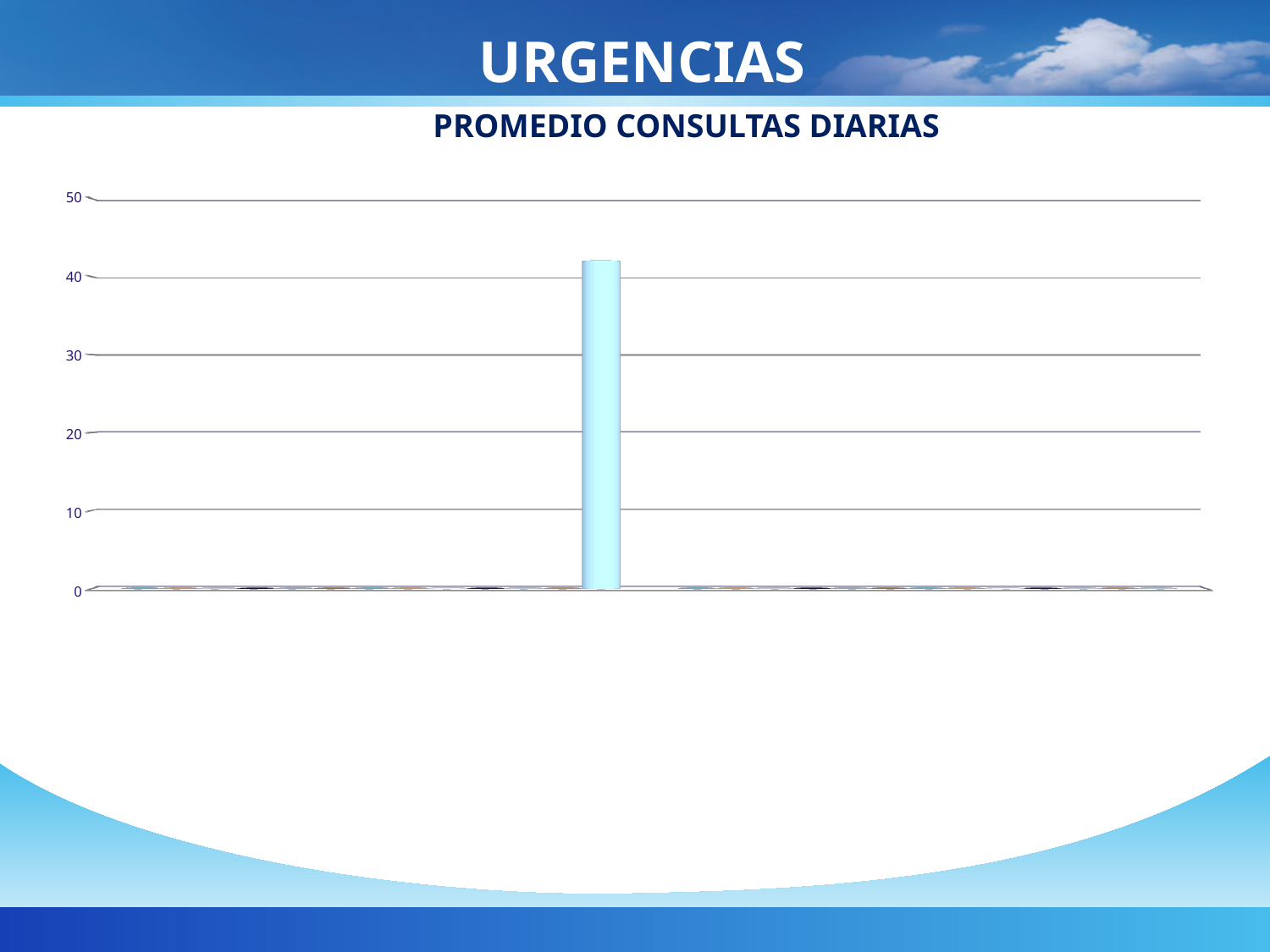
What is the title of the chart? PROMEDIO CONSULTAS DIARIAS Is the value of the visible bar greater or less than 30? greater Is the value of the visible bar greater or less than 50? less How many bars are visible in the chart? 1 What is the highest value shown on the vertical axis? 50 What kind of chart is shown on the slide? bar chart